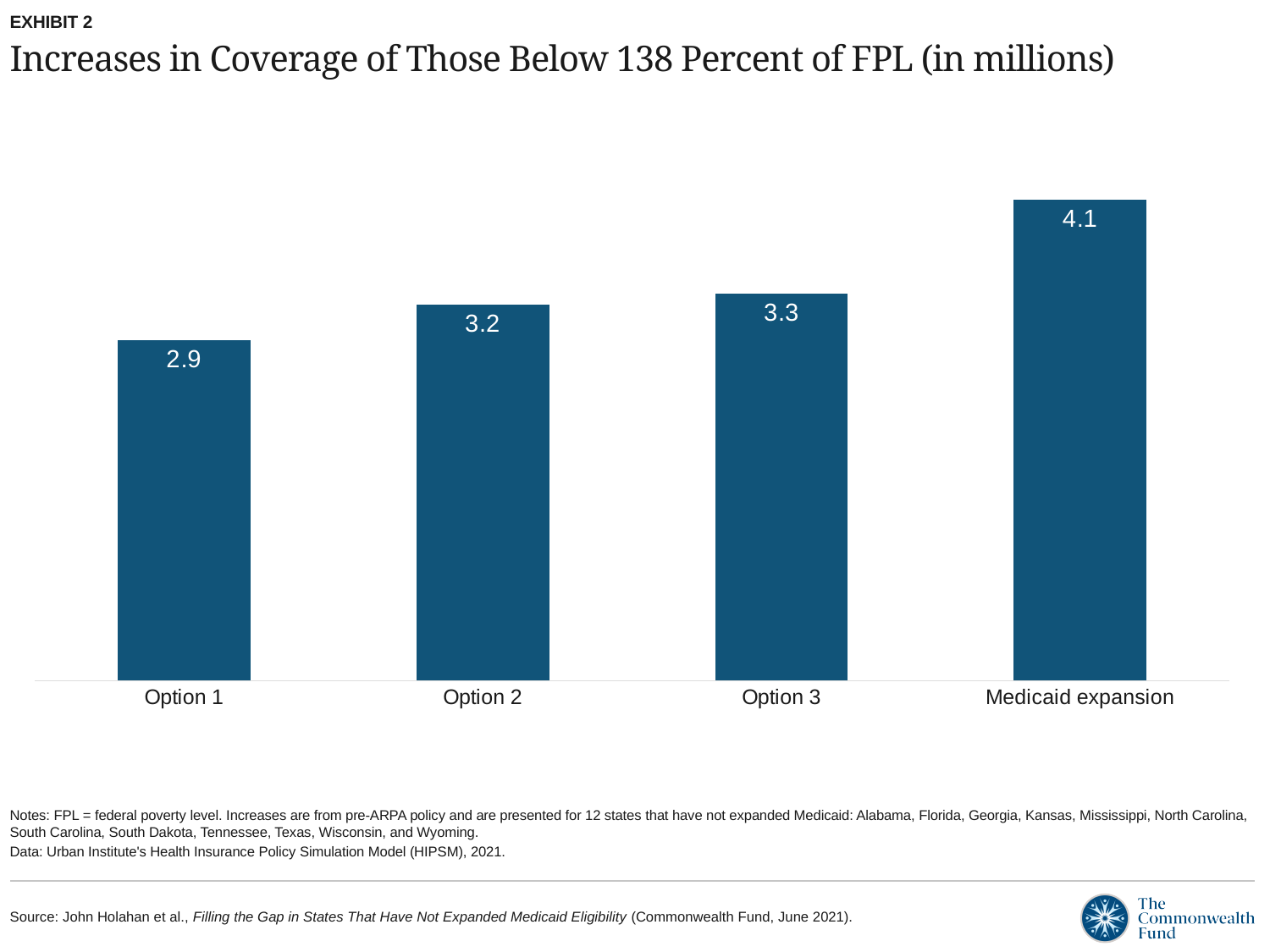
What kind of chart is shown on the slide? Bar chart What is the value for Option 3? 3.3 How many categories are shown in the chart? 4 Which category has the lowest value? Option 1 What is the value for Medicaid expansion? 4.1 What is the difference between the values for Option 2 and Option 1? 0.3 Which category has the highest value? Medicaid expansion What is the value for Option 1? 2.9 Which is larger, the value for Option 2 or the value for Medicaid expansion? Medicaid expansion Do the values rise or fall from Option 1 to Medicaid expansion along the x axis? Rise What is the difference between the values for Medicaid expansion and Option 1? 1.2 What is the value for Option 2? 3.2